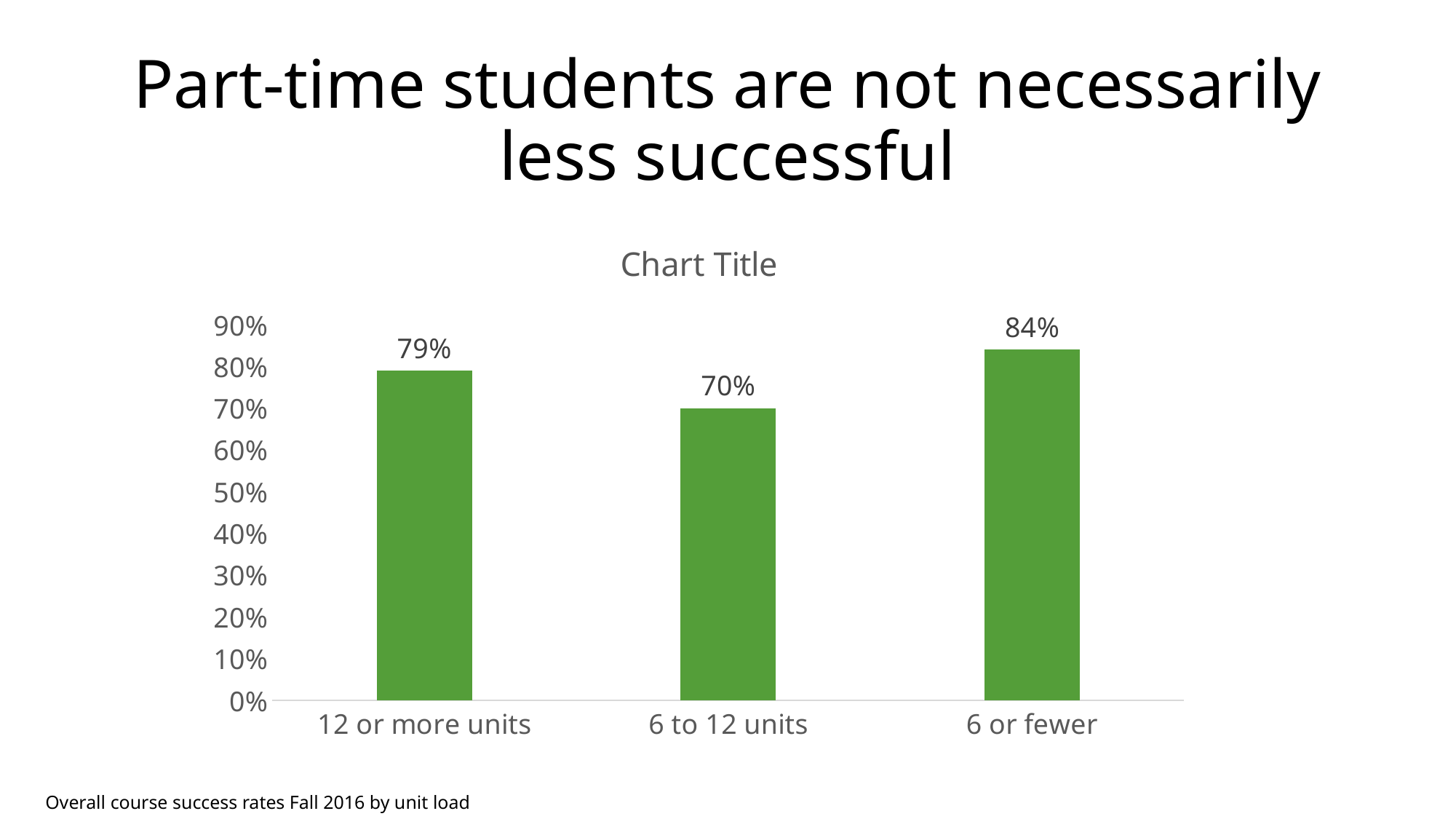
Which unit-load category has the lowest success rate? 6 to 12 units What is the title shown above the chart? Chart Title What is the success rate for students taking 6 or fewer units? 84% How many unit-load categories are shown in the chart? 3 Is the value for 6 to 12 units greater or less than 80%? less What is the success rate for students taking 6 to 12 units? 70% What is the difference in success rate between the 6 or fewer and 12 or more units categories? 5% Which unit-load category has the highest success rate? 6 or fewer What kind of chart is shown on the slide? Bar chart What is the success rate for students taking 12 or more units? 79% Which has a higher success rate: 12 or more units or 6 to 12 units? 12 or more units What is the difference in success rate between the 12 or more units and 6 to 12 units categories? 9%